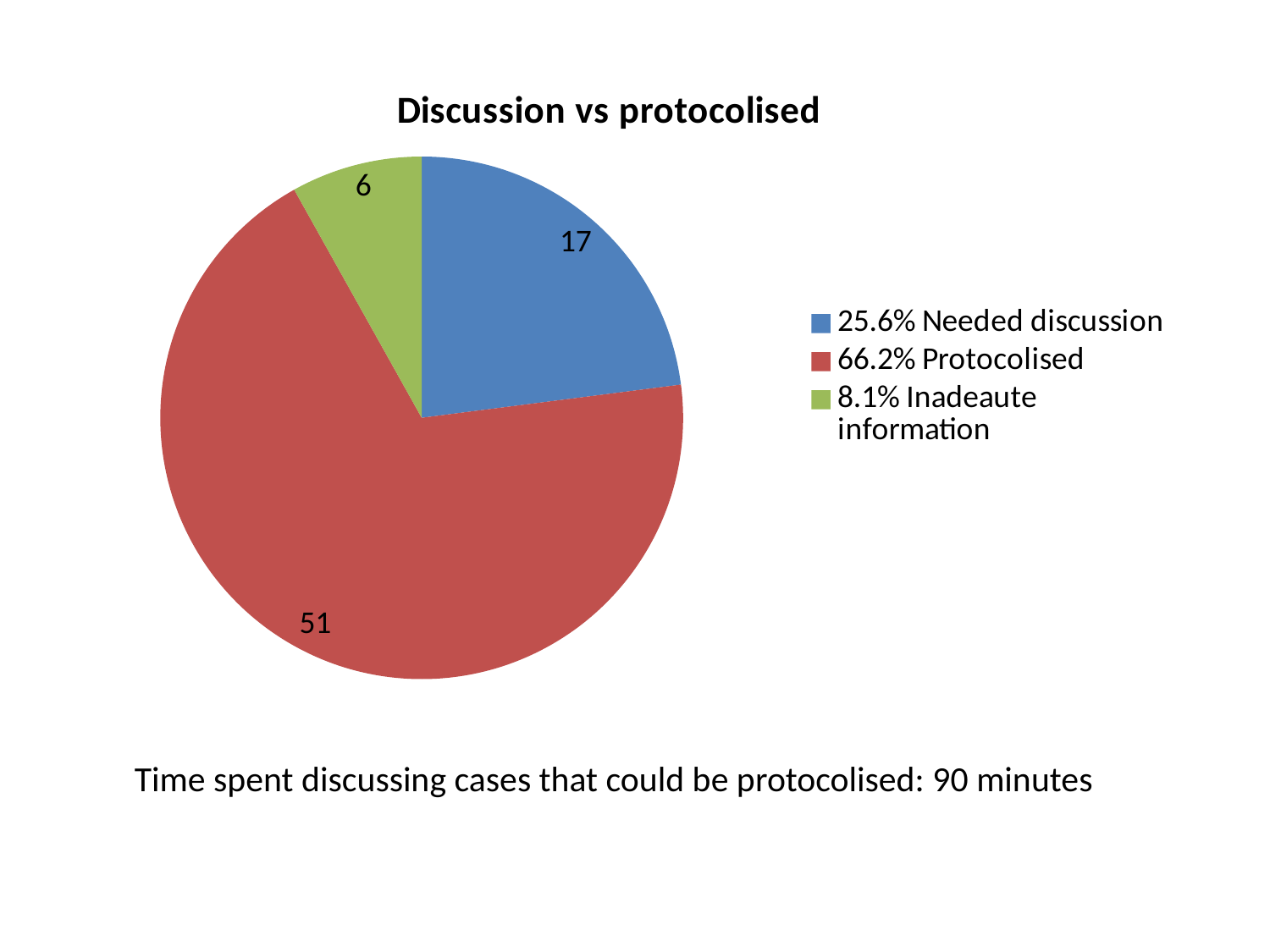
What is the title of the chart? Discussion vs protocolised Which is larger, the Needed discussion slice or the Inadeaute information slice? Needed discussion Which category has the largest slice? Protocolised What is the value for the Needed discussion slice? 17 How many slices does the pie chart have? 3 What is the value for the Inadeaute information slice? 6 What colour is the Needed discussion slice? blue Which category has the smallest slice? Inadeaute information What is the difference between the Protocolised and Needed discussion values? 34 What is the value for the Protocolised slice? 51 What type of chart is shown on the slide? pie chart What share of the pie does the Protocolised slice represent, as shown in the legend? 66.2%